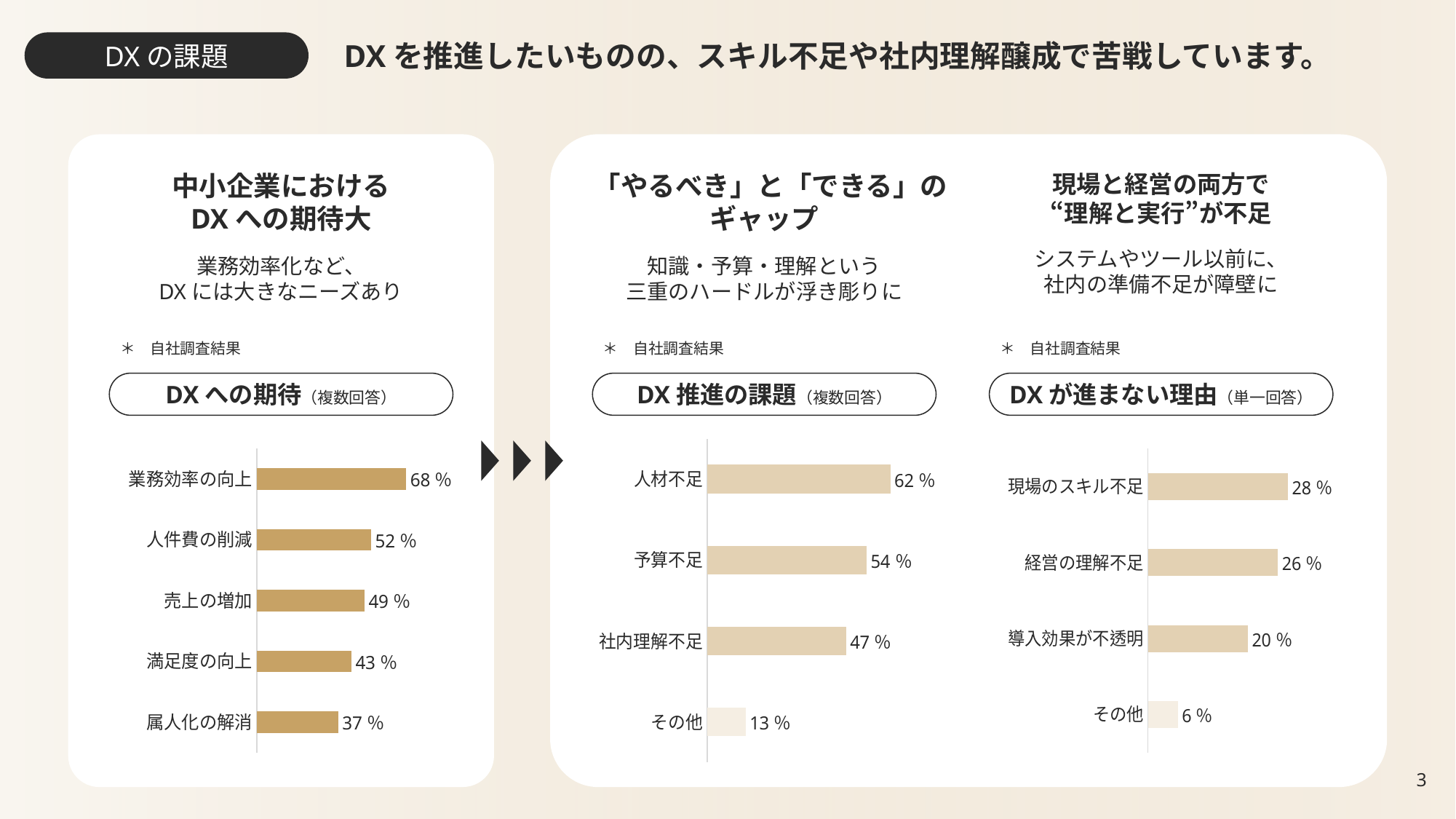
In the 'DX推進の課題' chart, what is the difference between 人材不足 and 社内理解不足? 15 % In the 'DXが進まない理由' chart, how many categories are shown? 4 In the 'DX推進の課題' chart, which category has the highest value? 人材不足 In the 'DX推進の課題' chart, which is larger, 社内理解不足 or その他? 社内理解不足 In the 'DXが進まない理由' chart, which category has the lowest value? その他 In the 'DXへの期待' chart, what is the difference between 業務効率の向上 and 人件費の削減? 16 % In the 'DXへの期待' chart, how many categories are shown? 5 In the 'DXへの期待' chart, what is the value for 業務効率の向上? 68 % In the 'DXへの期待' chart, which category has the lowest value? 属人化の解消 In the 'DX推進の課題' chart, what is the value for 予算不足? 54 % In the 'DXが進まない理由' chart, what is the value for 経営の理解不足? 26 % What type of chart is the 'DXが進まない理由' chart? Bar chart